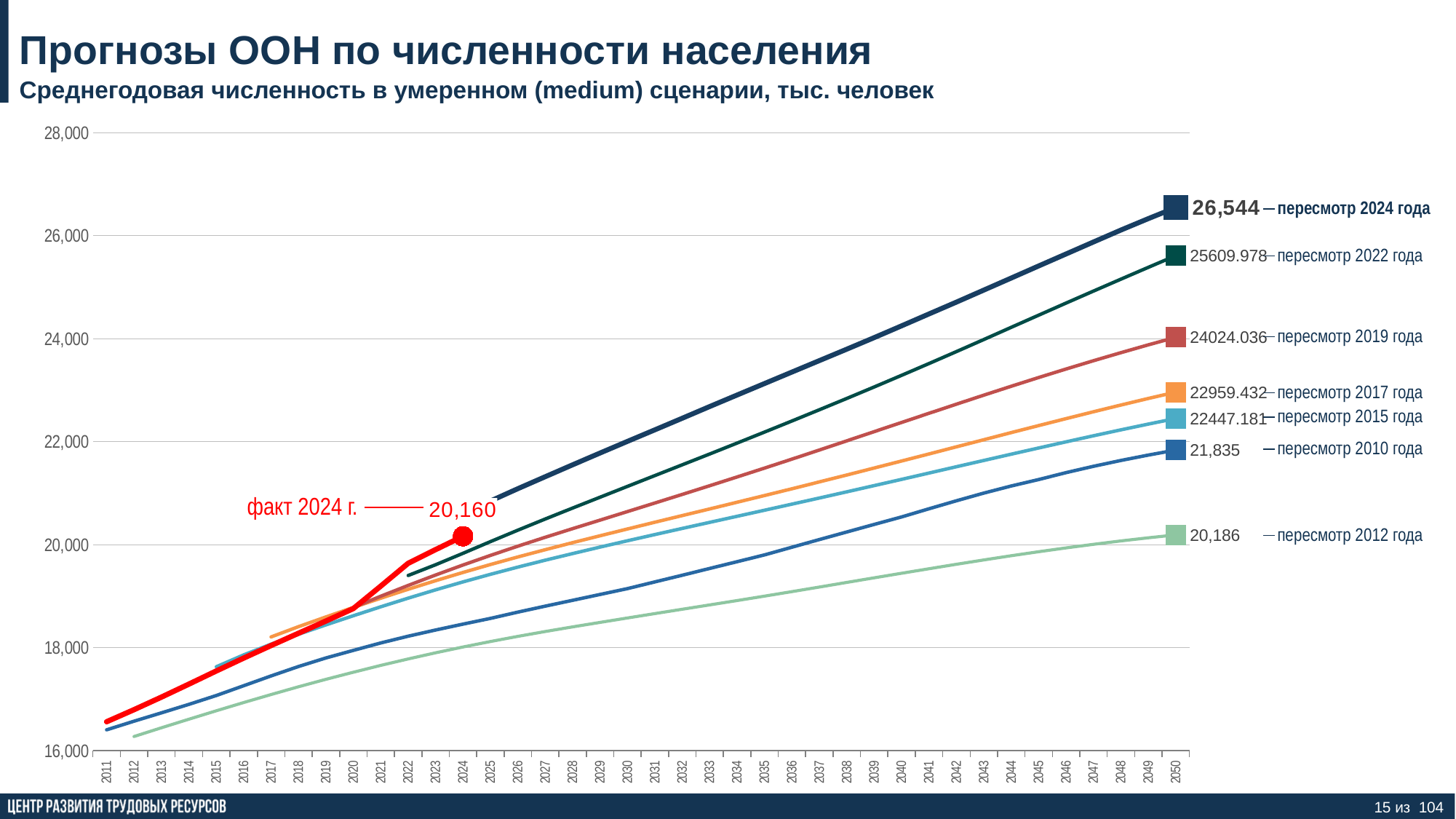
Which series has the highest value in 2050? пересмотр 2024 года What is the 2050 value for the 'пересмотр 2022 года' series? 25609.978 Do the forecast lines rise or fall from 2011 to 2050? rise Is the 2050 value for 'пересмотр 2010 года' greater or less than 22,000? less What type of chart is shown on the slide? line chart What is the difference between the 2050 values of 'пересмотр 2024 года' and 'пересмотр 2010 года'? 4,709 What is the 2050 value for the 'пересмотр 2012 года' series? 20,186 Which is larger in 2050: 'пересмотр 2017 года' or 'пересмотр 2015 года'? пересмотр 2017 года What is the 2050 value for the 'пересмотр 2019 года' series? 24024.036 What is the 2050 value for the 'пересмотр 2024 года' series? 26,544 Which series has the lowest value in 2050? пересмотр 2012 года What is the value labelled 'факт 2024 г.'? 20,160